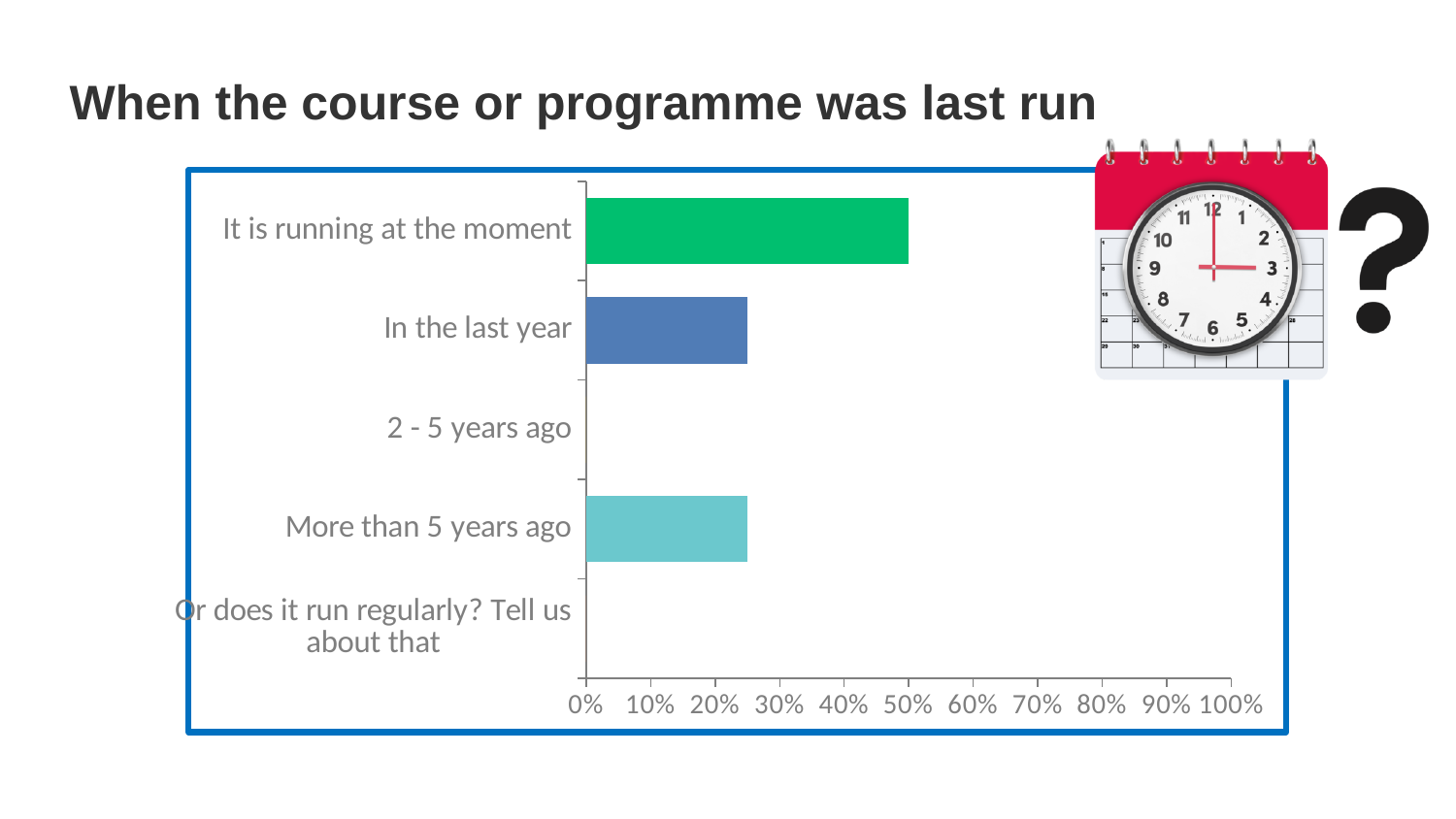
How many categories are shown on the chart's vertical axis? 5 Is the value for "More than 5 years ago" greater or less than 30%? less What kind of chart is shown on the slide? bar chart Is the value for "In the last year" greater or less than 30%? less What is the title of the chart? When the course or programme was last run Is the value for "It is running at the moment" greater or less than 40%? greater What is the value for "It is running at the moment"? 50% How many categories have no bar shown at all? 2 Which is larger, the value for "It is running at the moment" or the value for "In the last year"? It is running at the moment Which category has the highest value? It is running at the moment What is the highest value shown on the horizontal axis? 100%